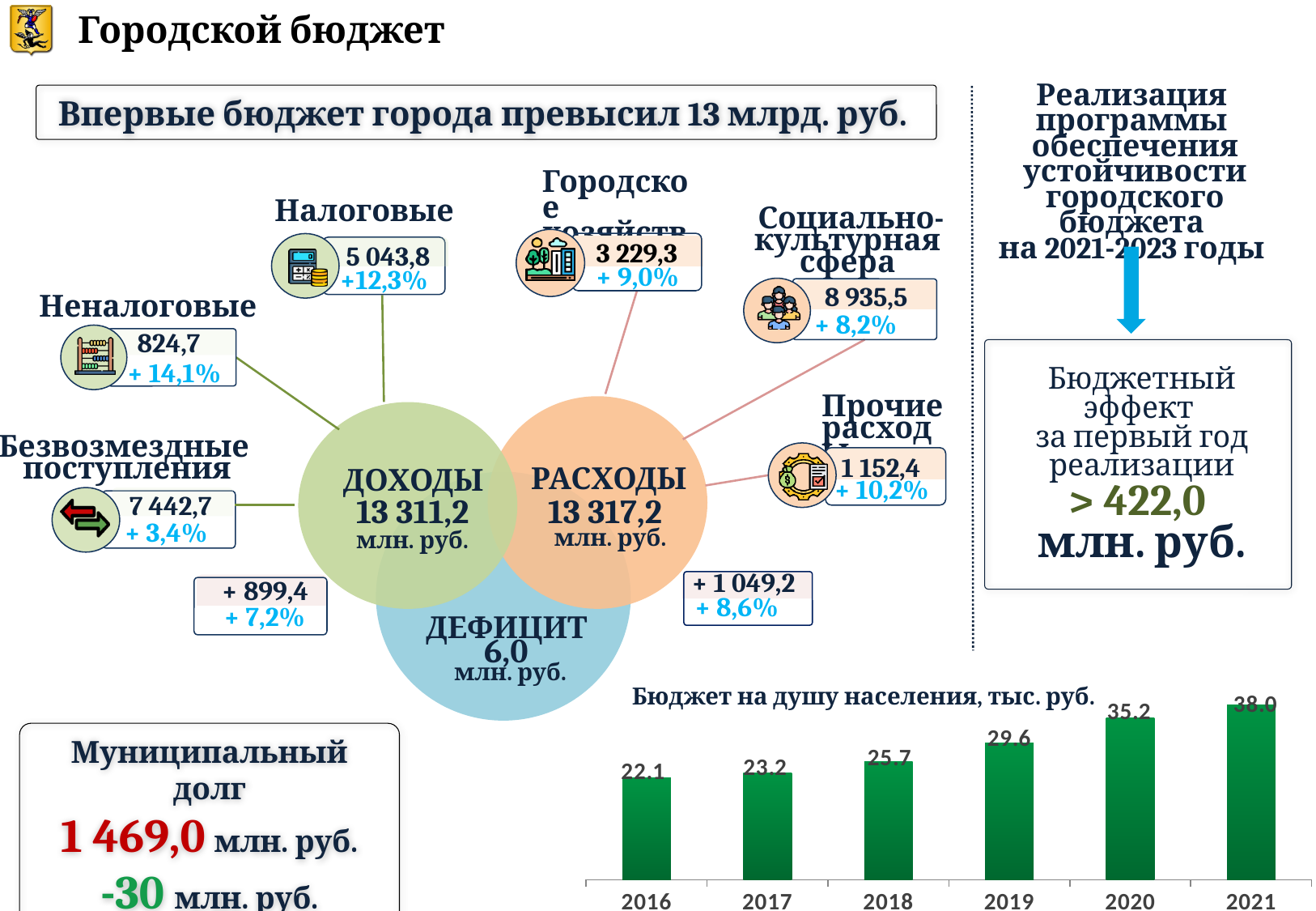
In the bar chart 'Бюджет на душу населения, тыс. руб.', do the values rise or fall from 2016 to 2021? Rise What is the value for 2016 in the bar chart 'Бюджет на душу населения, тыс. руб.'? 22.1 What is the value for 2021 in the bar chart 'Бюджет на душу населения, тыс. руб.'? 38.0 How many years are shown in the bar chart 'Бюджет на душу населения, тыс. руб.'? 6 What kind of chart is 'Бюджет на душу населения, тыс. руб.'? Bar chart In the bar chart 'Бюджет на душу населения, тыс. руб.', which year has the highest value? 2021 In the bar chart 'Бюджет на душу населения, тыс. руб.', which year has the larger value, 2017 or 2018? 2018 In the bar chart 'Бюджет на душу населения, тыс. руб.', what is the difference between the values for 2020 and 2019? 5.6 In the bar chart 'Бюджет на душу населения, тыс. руб.', which year has the lowest value? 2016 What is the value for 2018 in the bar chart 'Бюджет на душу населения, тыс. руб.'? 25.7 What is the value for 2019 in the bar chart 'Бюджет на душу населения, тыс. руб.'? 29.6 In the bar chart 'Бюджет на душу населения, тыс. руб.', what is the difference between the values for 2021 and 2016? 15.9